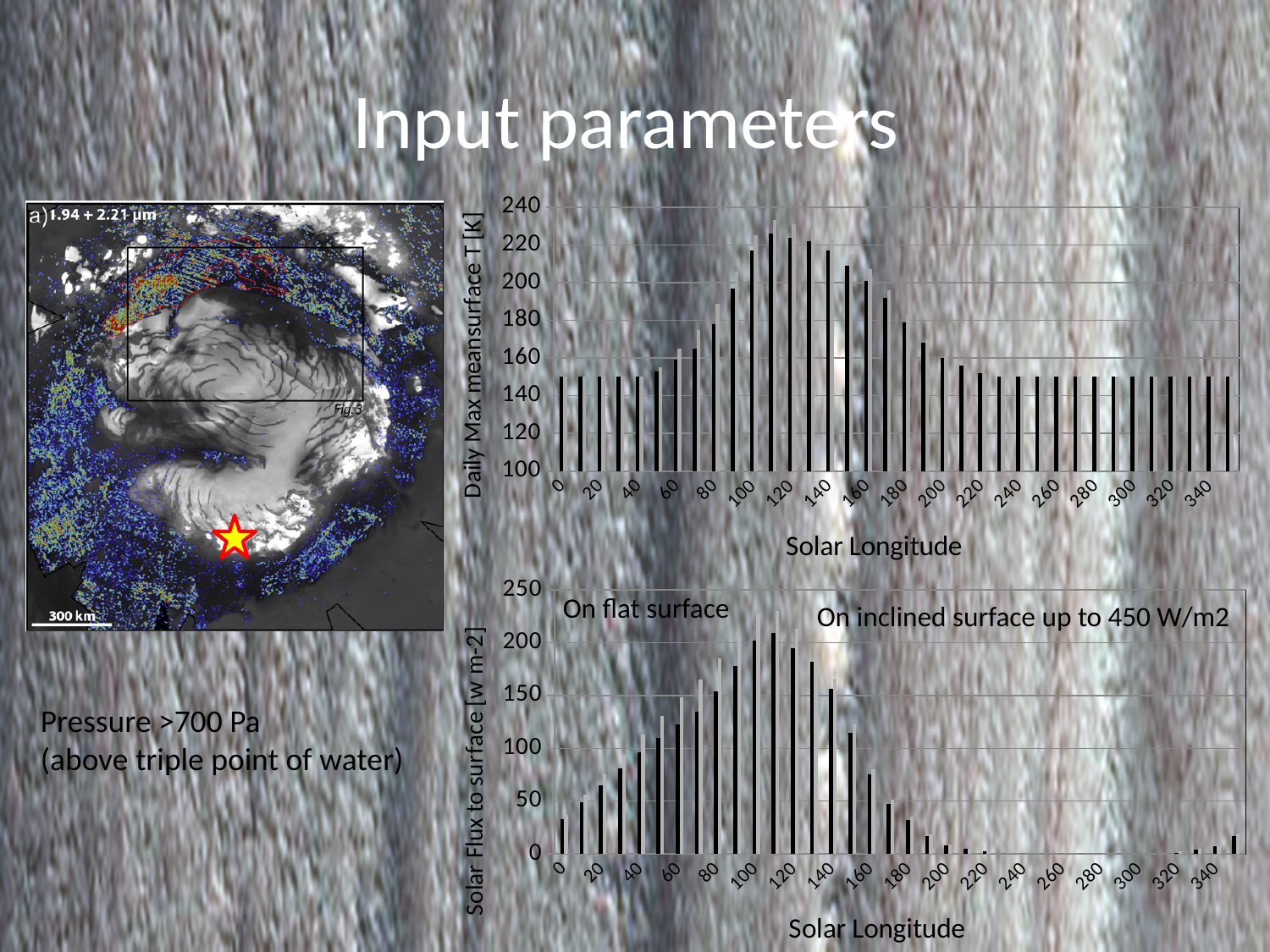
In the bottom chart, do the values rise or fall between solar longitude 0 and 100? rise In the top chart, do the values rise or fall between solar longitude 140 and 200? fall In the top chart, what is the label of the y axis? Daily Max meansurface T [K] In the bottom chart, which is larger, the value at solar longitude 100 or at 200? 100 In the bottom chart, what is the label of the x axis? Solar Longitude In the top chart, is the value at solar longitude 120 greater or less than 200? greater In the top chart, which is larger, the value at solar longitude 120 or at 240? 120 What kind of chart is the bottom chart on the slide? bar chart In the bottom chart, is the value at solar longitude 0 greater or less than 50? less What kind of chart is the top chart on the slide? bar chart In the bottom chart, is the value at solar longitude 140 greater or less than 100? greater